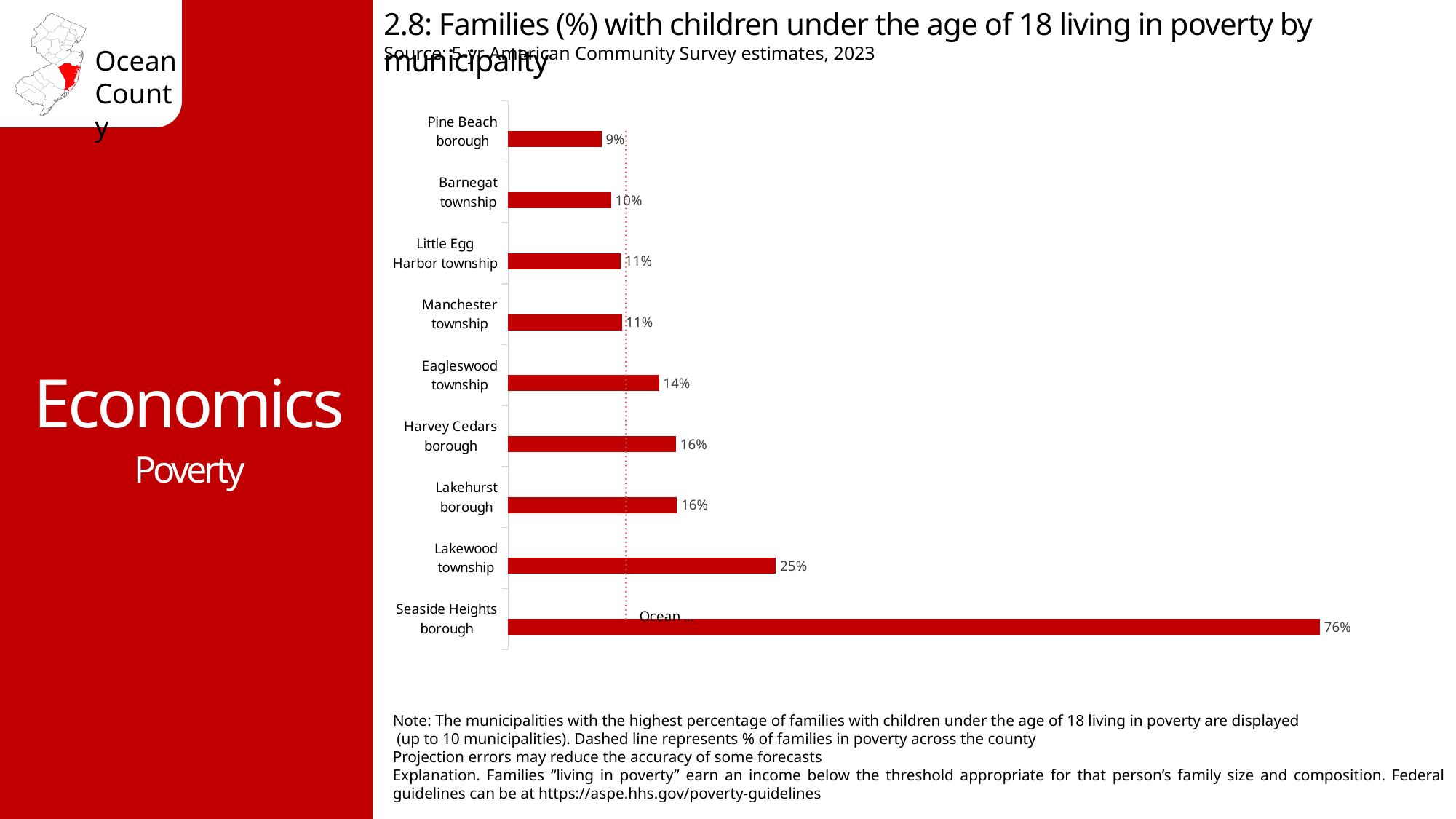
What is the value shown for Pine Beach borough? 9% Which municipality has the lowest percentage shown on the chart? Pine Beach borough Which has a higher value, Lakewood township or Eagleswood township? Lakewood township What is the value shown for Eagleswood township? 14% What is the difference between the values for Harvey Cedars borough and Barnegat township? 6% What percentage of families with children under 18 are living in poverty in Seaside Heights borough? 76% Which municipality has the highest percentage of families with children under 18 living in poverty? Seaside Heights borough According to the note, what does the dashed line on the chart represent? % of families in poverty across the county What is the difference between the values for Seaside Heights borough and Lakewood township? 51% What is the value shown for Lakewood township? 25% What type of chart is used on this slide? Bar chart How many municipalities are shown on the chart? 9